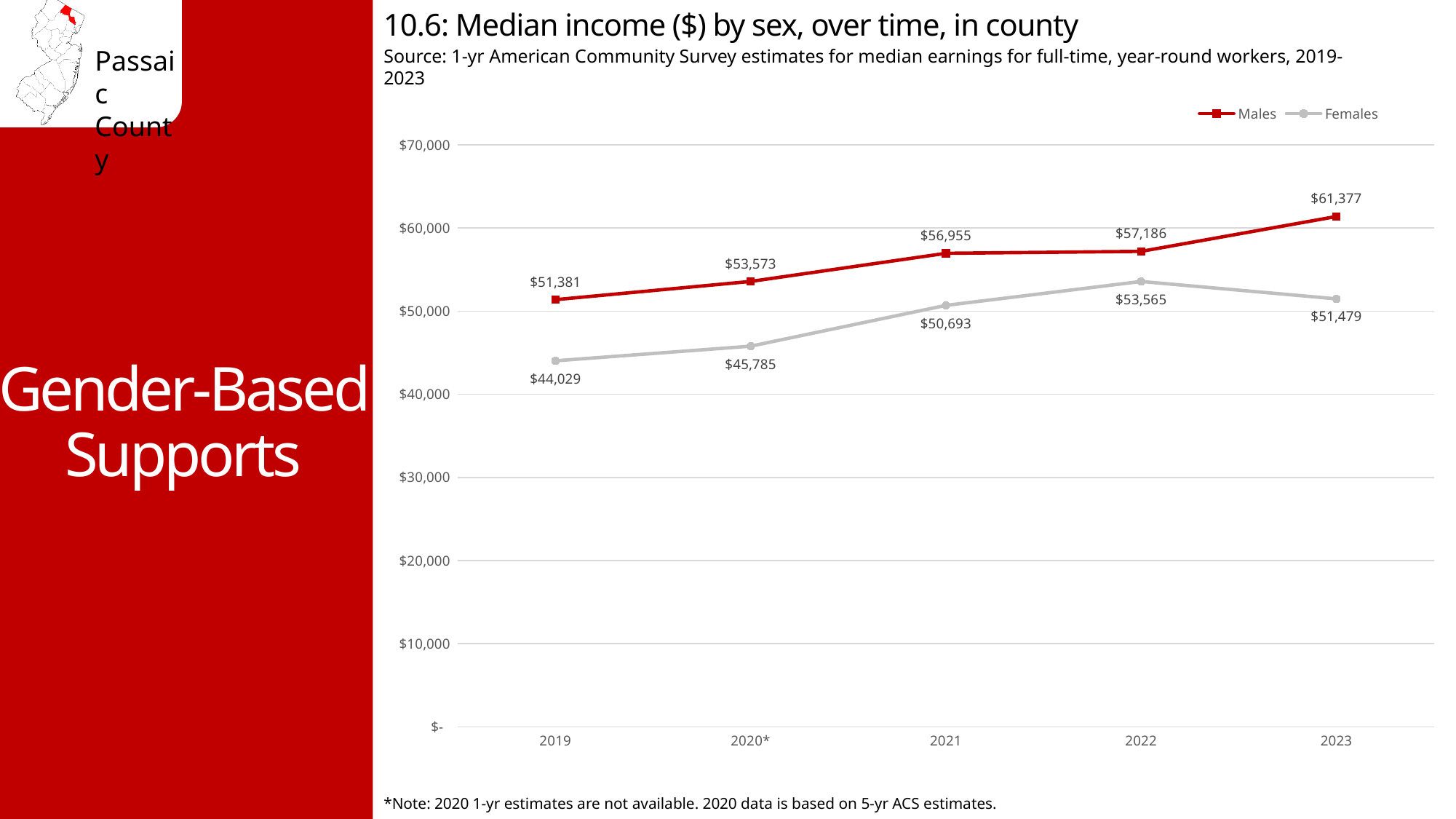
What was the median income for Males in 2023? $61,377 In which year was the median income for Males lowest? 2019 Which was larger in 2022, the median income for Males or for Females? Males What colour is the line for Females? Grey What is the difference between the Males and Females median income in 2023? $9,898 How many years are shown on the x axis? 5 In which year was the median income for Females highest? 2022 What was the median income for Females in 2019? $44,029 How many series does the legend list? 2 What was the median income for Females in 2021? $50,693 What kind of chart is shown on the slide? Line chart Did the median income for Males rise or fall from 2019 to 2023? Rise